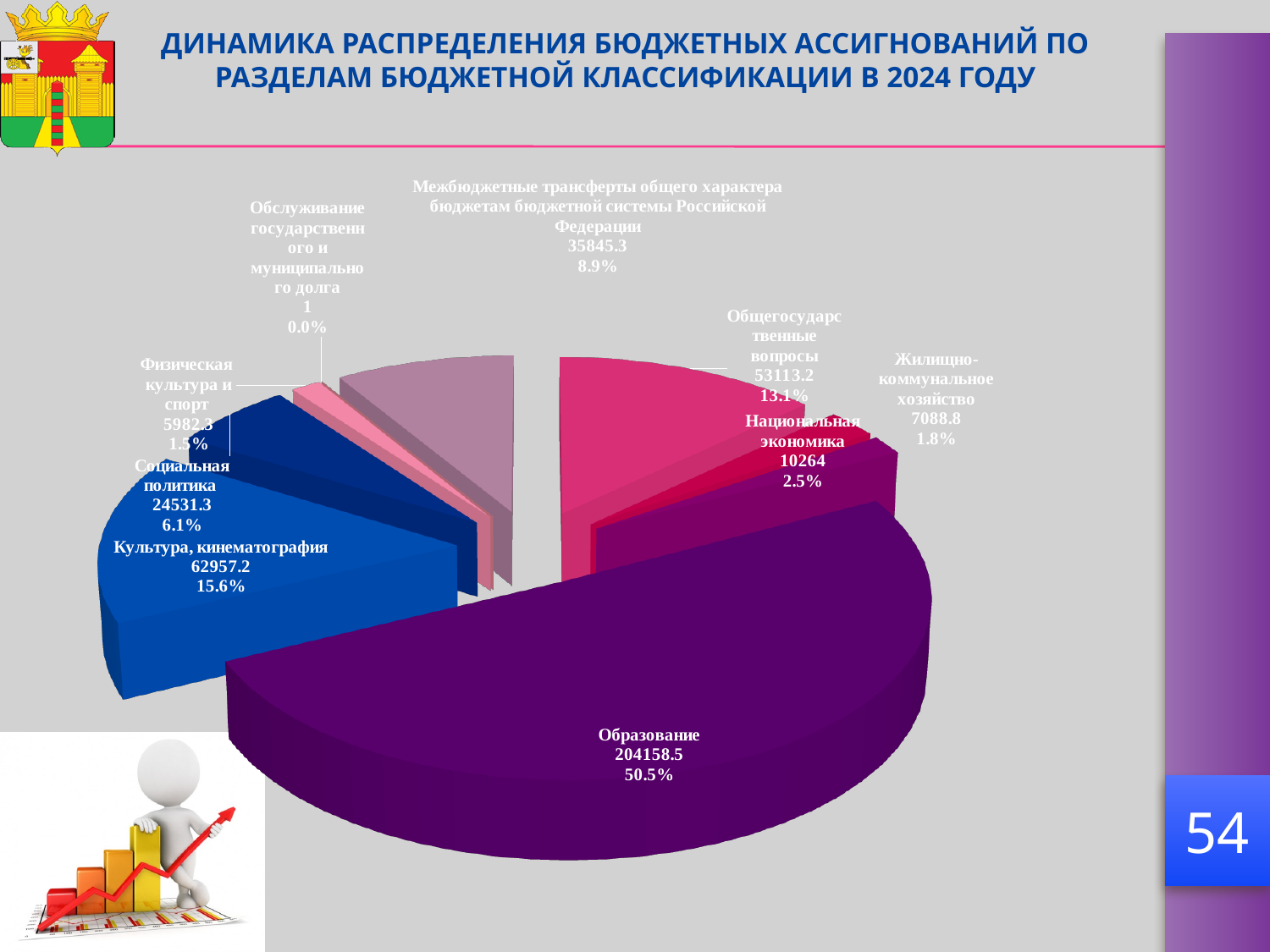
Which category has the smallest slice of the pie? Обслуживание государственного и муниципального долга What value is shown for Образование? 204158.5 What kind of chart is shown on the slide? pie chart What value is shown for Культура, кинематография? 62957.2 What is the difference between the values for Культура, кинематография and Общегосударственные вопросы? 9844 Which is larger: the value for Национальная экономика or the value for Жилищно-коммунальное хозяйство? Национальная экономика Which category has the largest slice of the pie? Образование What share of the pie does Образование take? 50.5% What share of the pie does Общегосударственные вопросы take? 13.1% What share of the pie does Физическая культура и спорт take? 1.5% What value is shown for Социальная политика? 24531.3 How many categories are shown in the pie chart? 9